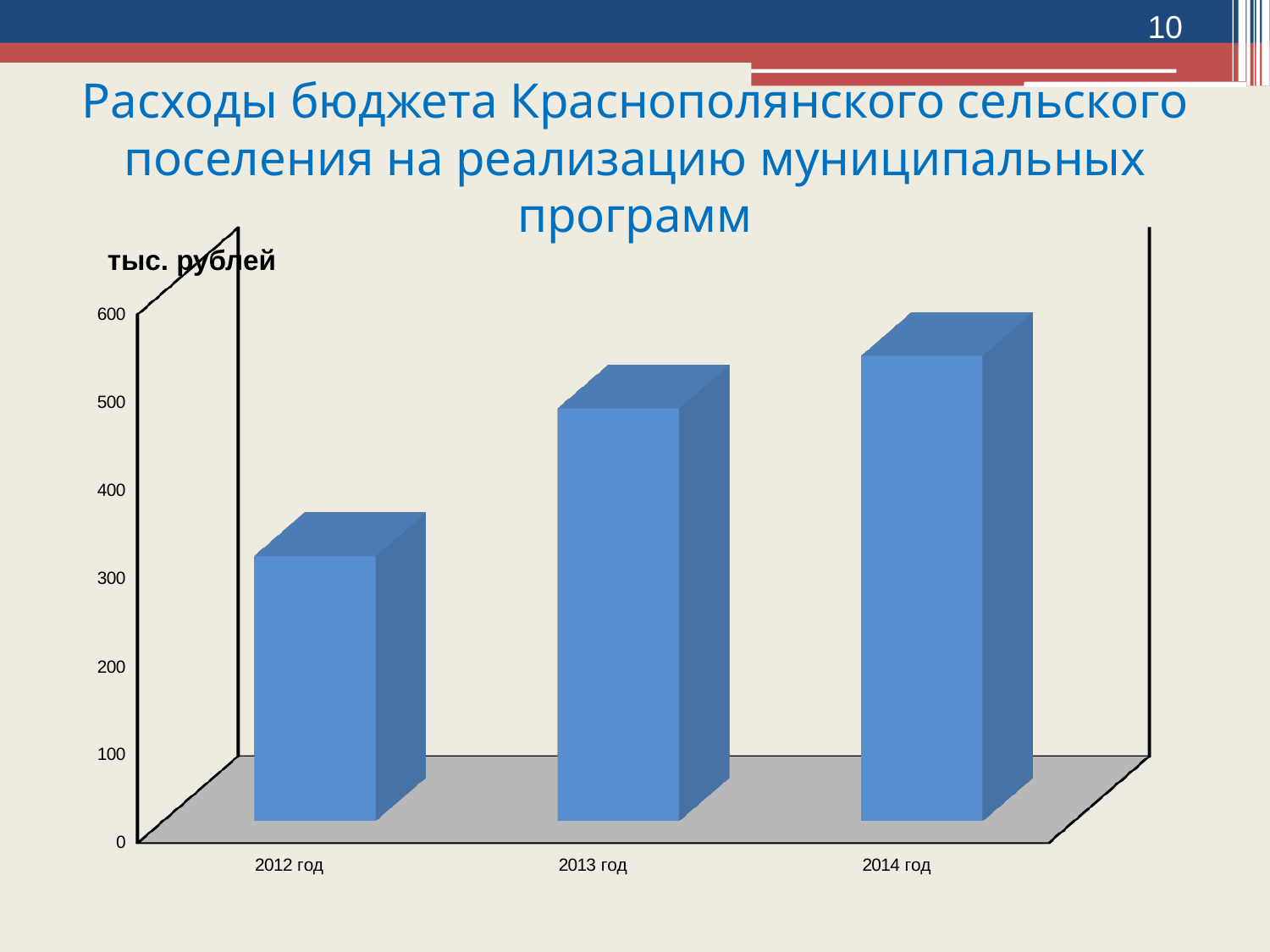
Which year has the lowest budget expenditure on municipal programs? 2012 год Is the value for 2012 год greater or less than 400? less What is the maximum value shown on the vertical axis? 600 What unit is indicated for the vertical axis of the chart? тыс. рублей How many years (categories) are plotted on the chart? 3 Is the value for 2014 год greater or less than 600? less Is the value for 2013 год greater or less than 400? greater What kind of chart is shown on the slide? bar chart Do the expenditures rise or fall from 2012 to 2014? rise Which year has the highest budget expenditure on municipal programs? 2014 год Which is larger, the value for 2013 год or the value for 2012 год? 2013 год